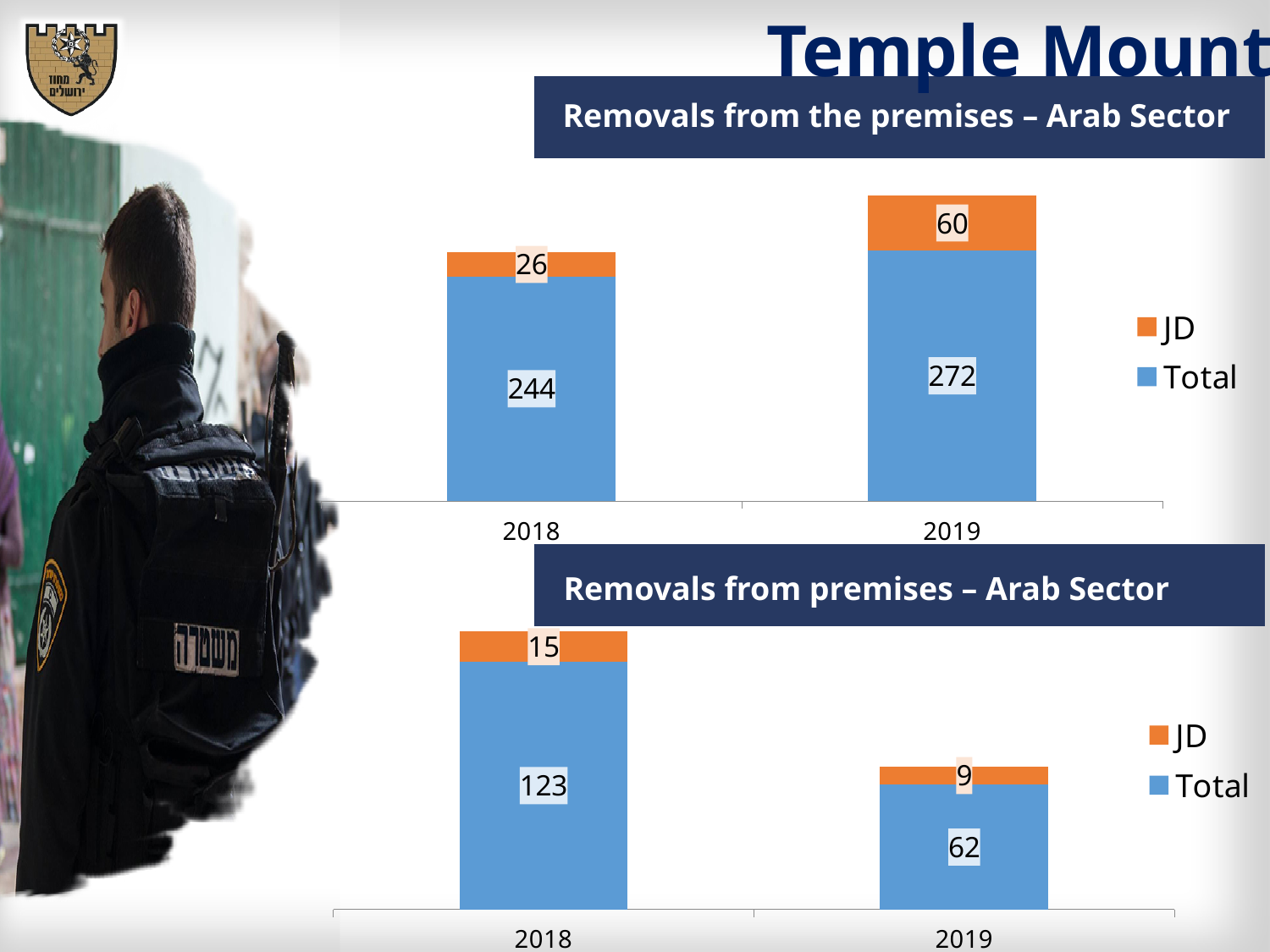
In the bottom chart, is the JD value for 2018 larger or smaller than the JD value for 2019? larger In the bottom chart, what is the JD value for 2018? 15 In the bottom chart, what is the difference between the Total values for 2018 and 2019? 61 In the top chart, what is the Total value for 2018? 244 In the top chart, what is the JD value for 2019? 60 In the top chart, which year has the higher Total value? 2019 What type of chart is the bottom chart? Stacked bar chart In the top chart, what is the combined height of the 2019 stacked bar (Total plus JD)? 332 In the top chart, what is the difference between the JD values for 2019 and 2018? 34 In the bottom chart, what is the Total value for 2019? 62 In the bottom chart, which year has the lower Total value? 2019 How many series does the legend of the top chart list? 2